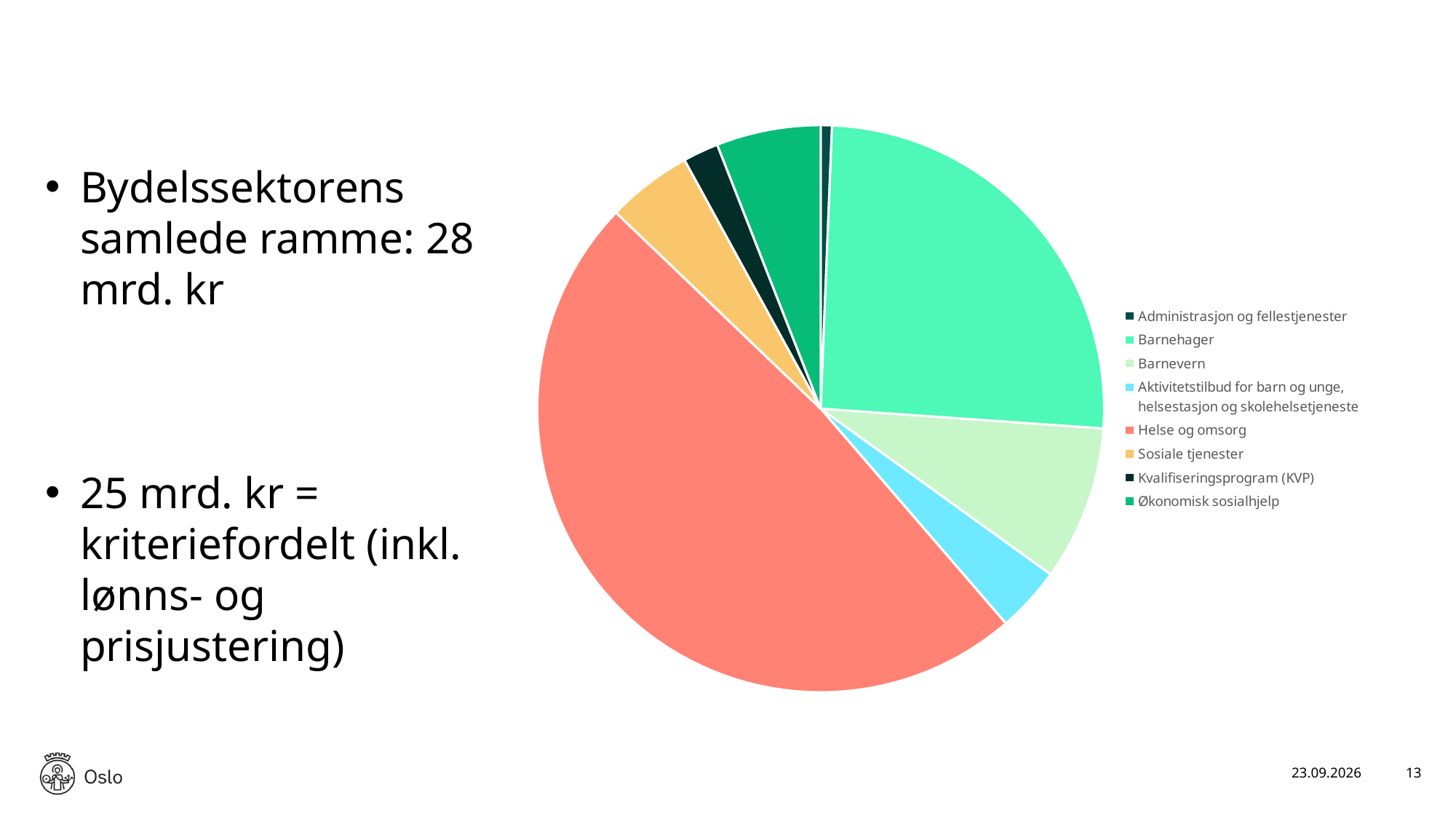
Which slice is larger, Helse og omsorg or Barnehager? Helse og omsorg How many categories does the pie chart's legend list? 8 Which category has the largest slice of the pie chart? Helse og omsorg What kind of chart is shown on the slide? pie chart Which slice is larger, Barnevern or Aktivitetstilbud for barn og unge, helsestasjon og skolehelsetjeneste? Barnevern Which category has the smallest slice of the pie chart? Administrasjon og fellestjenester What colour is the Helse og omsorg slice in the pie chart? salmon red Which slice is larger, Økonomisk sosialhjelp or Kvalifiseringsprogram (KVP)? Økonomisk sosialhjelp Which category is the second-largest slice of the pie chart? Barnehager